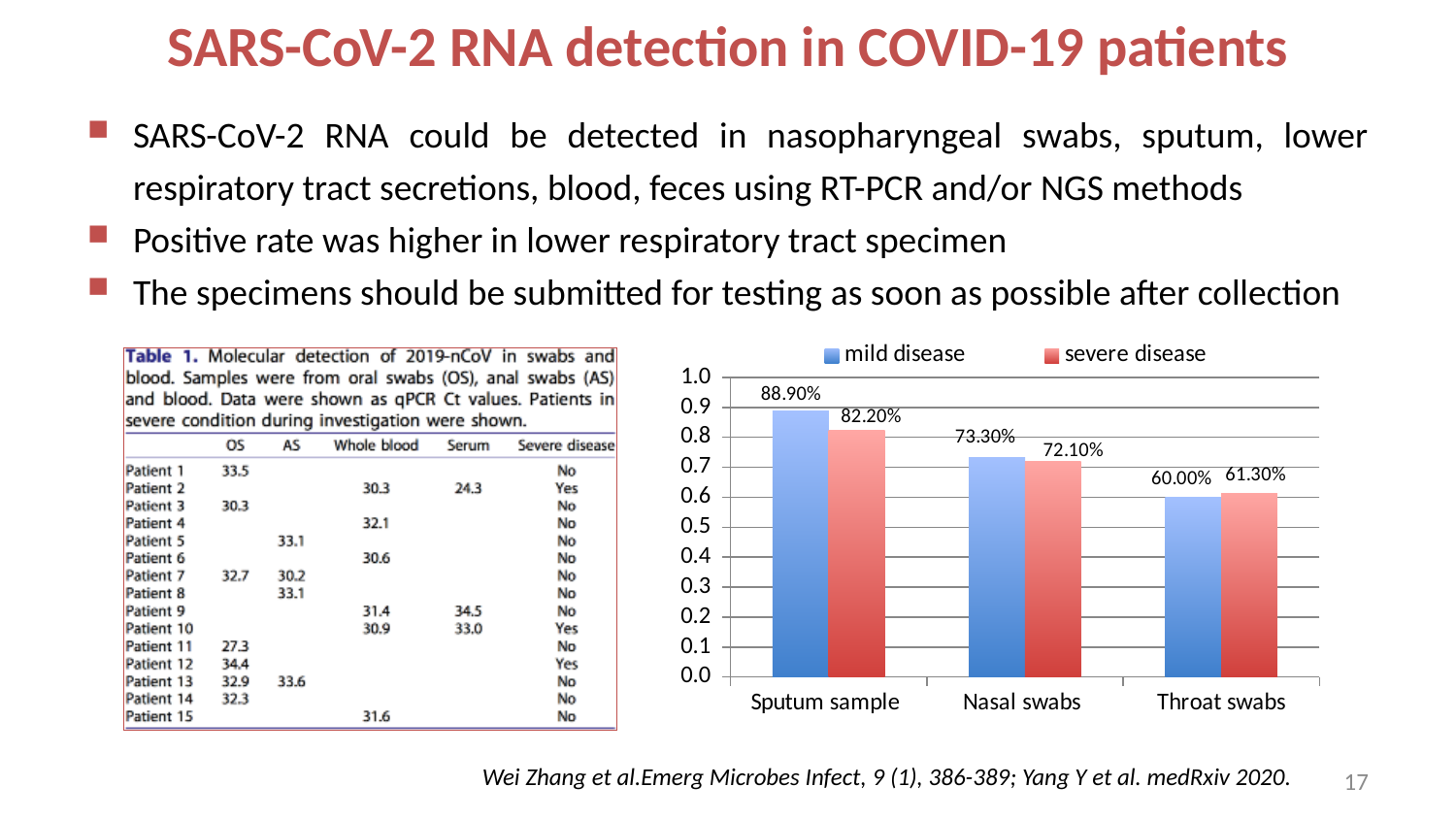
In the bar chart, what is the value for severe disease in the Nasal swabs category? 72.10% In the bar chart, do the mild disease values rise or fall from Sputum sample to Throat swabs? fall In the bar chart, what is the difference between the mild disease and severe disease values for Sputum sample? 6.70% In the bar chart, what is the value for mild disease in the Sputum sample category? 88.90% In the bar chart, is the mild disease value for Nasal swabs greater or less than 0.8? less How many categories are shown on the x axis of the bar chart? 3 In the bar chart, which category has the highest value for mild disease? Sputum sample In the bar chart, which is larger for Throat swabs: the mild disease value or the severe disease value? severe disease What kind of chart is shown on the right side of the slide? bar chart How many series does the legend of the bar chart list? 2 In the bar chart, what is the value for severe disease in the Throat swabs category? 61.30% In the bar chart, which category has the lowest value for severe disease? Throat swabs